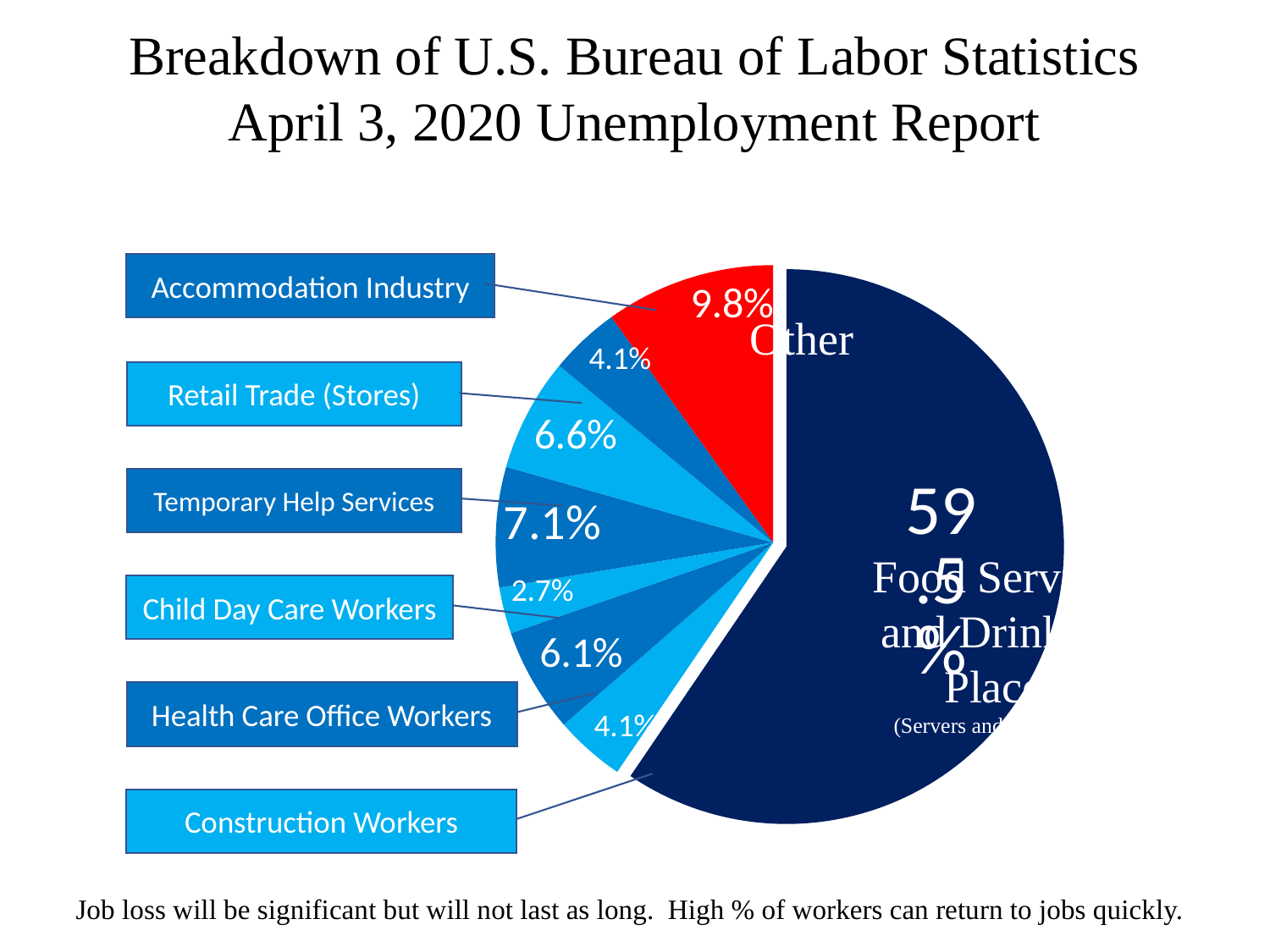
What percentage is shown for Temporary Help Services? 7.1% What percentage is shown for Retail Trade (Stores)? 6.6% What percentage is shown for Child Day Care Workers? 2.7% Which of the labelled categories has the smallest share of the pie? Child Day Care Workers What percentage is shown for Construction Workers? 4.1% What percentage is shown for Health Care Office Workers? 6.1% What percentage does the Other slice represent? 9.8% What kind of chart is shown on the slide? pie chart How much larger is the Temporary Help Services share than the Retail Trade (Stores) share? 0.5% What percentage is shown for the Accommodation Industry? 4.1% What colour is the Other slice of the pie? red Which has a larger share: Health Care Office Workers or Retail Trade (Stores)? Retail Trade (Stores)